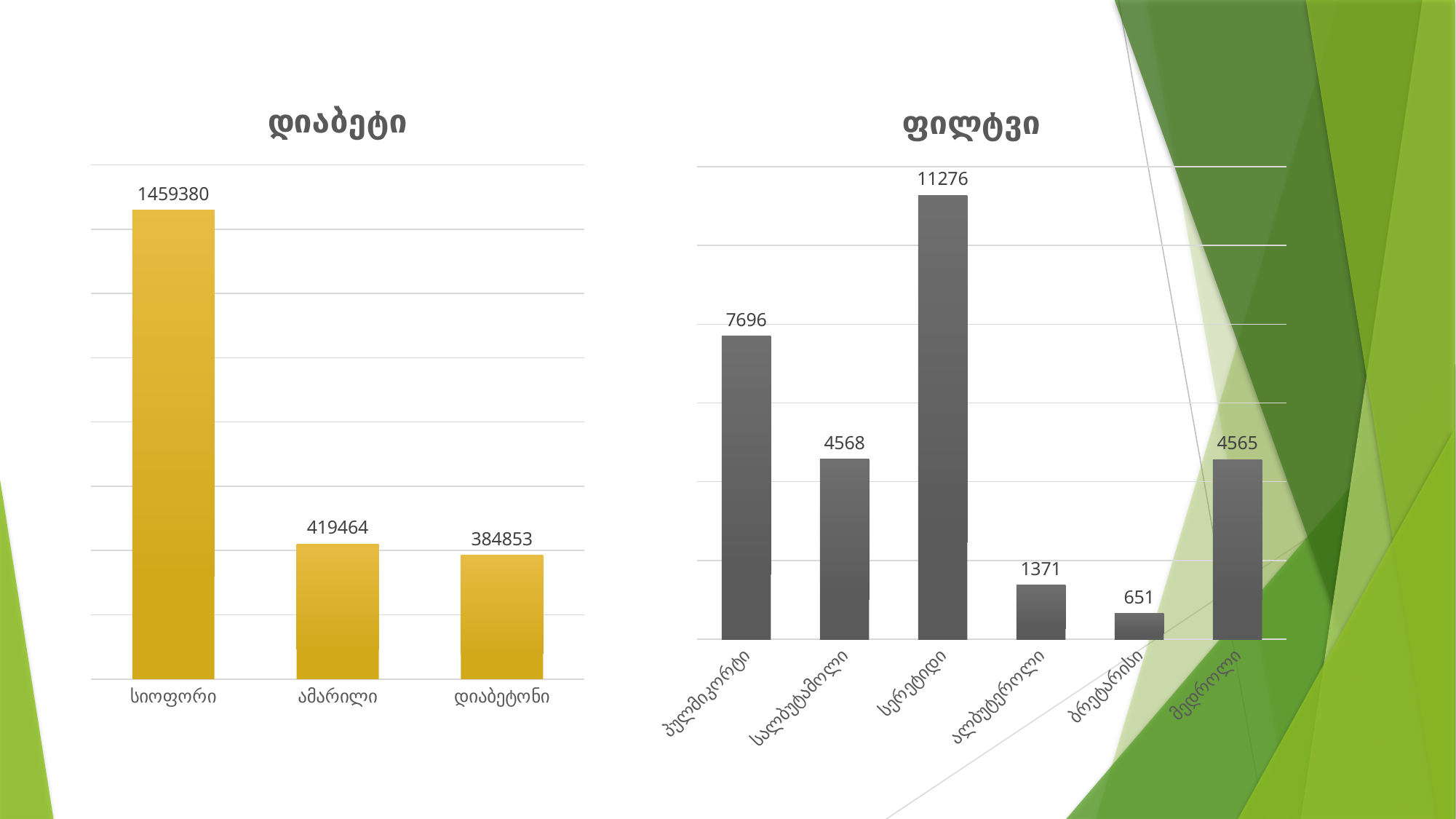
In the chart titled ფილტვი, which category has the highest value? სერეტიდი In the chart titled დიაბეტი, what is the value for სიოფორი? 1459380 In the chart titled ფილტვი, what is the value for სერეტიდი? 11276 In the chart titled დიაბეტი, which category has the lowest value? დიაბეტონი In the chart titled დიაბეტი, what is the difference between the values for ამარილი and დიაბეტონი? 34611 In the chart titled ფილტვი, which category has the lowest value? ბრეტარისი In the chart titled ფილტვი, what is the value for ბრეტარისი? 651 What kind of chart is the chart titled ფილტვი? bar chart In the chart titled ფილტვი, how many categories are shown? 6 In the chart titled ფილტვი, which is larger: the value for პულმიკორტი or the value for მედროლი? პულმიკორტი In the chart titled ფილტვი, what is the difference between the values for სერეტიდი and პულმიკორტი? 3580 In the chart titled დიაბეტი, how many categories are shown? 3